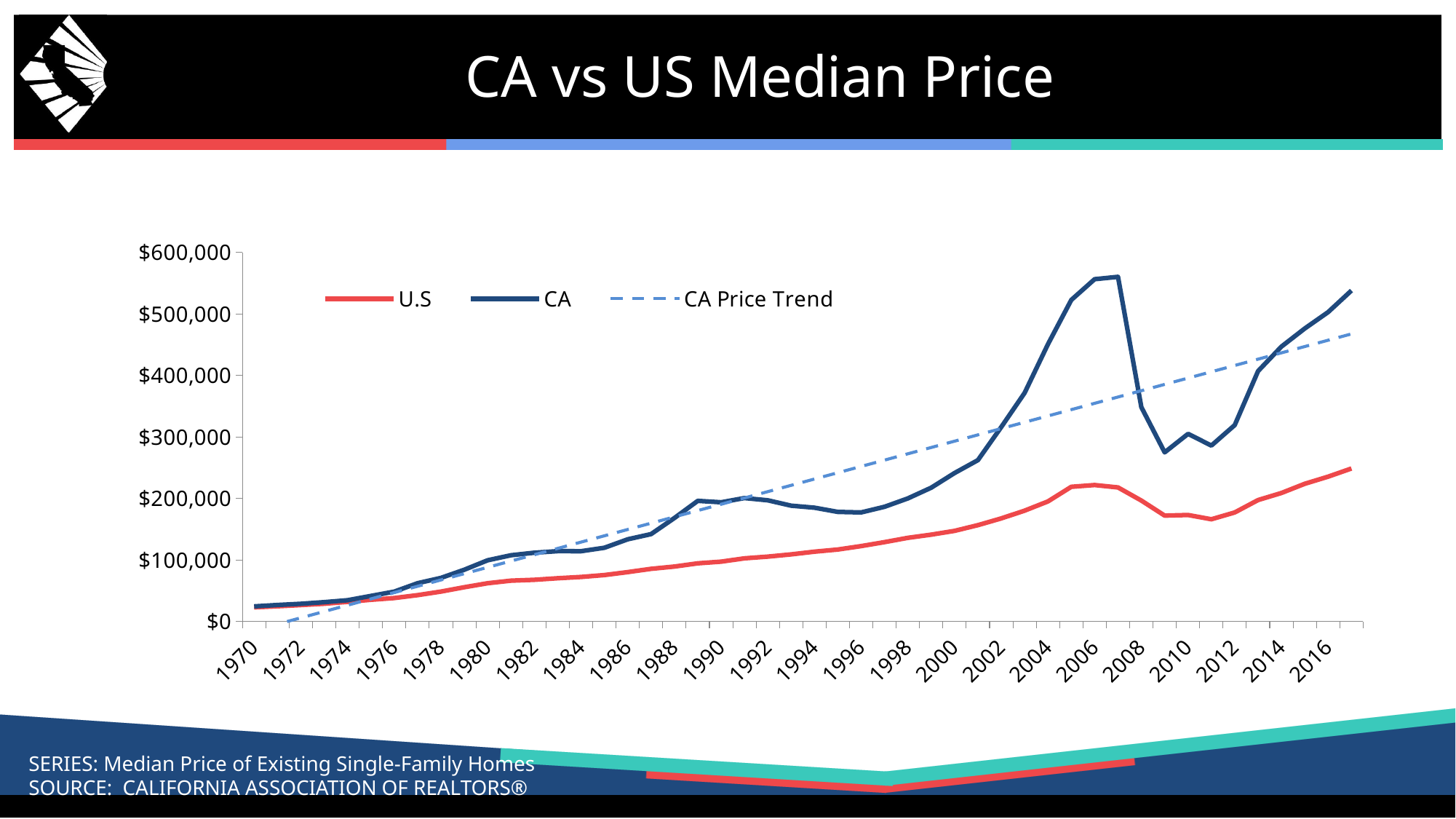
In 2006, which series has the higher value, CA or U.S? CA Which series in the legend is drawn as a dashed line? CA Price Trend How many series does the legend list? 3 Is the CA value in 2009 greater or less than $300,000? less Is the U.S value in 2006 greater or less than $200,000? greater What is the title of the chart? CA vs US Median Price Is the U.S value in 2016 greater or less than $300,000? less What kind of chart is shown on the slide? line chart Does the U.S line rise or fall between 2012 and 2016? rise Does the CA line rise or fall between 2007 and 2009? fall